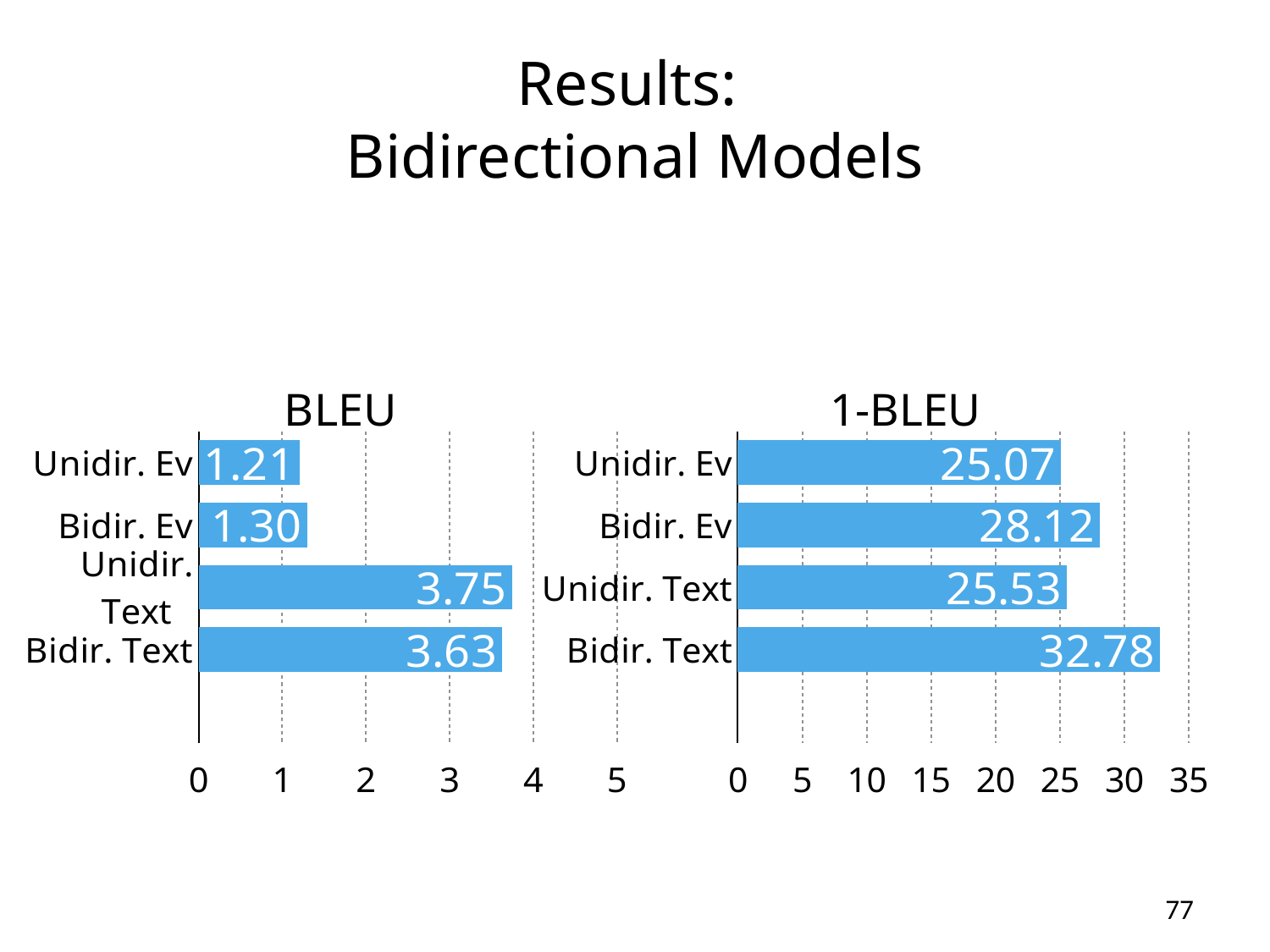
In the BLEU chart, what is the difference between Unidir. Text and Bidir. Text? 0.12 In the 1-BLEU chart, which category has the highest value? Bidir. Text In the BLEU chart, which is larger, Unidir. Ev or Bidir. Ev? Bidir. Ev In the 1-BLEU chart, what is the difference between Bidir. Text and Bidir. Ev? 4.66 In the 1-BLEU chart, what is the value for Unidir. Text? 25.53 What is the title of the chart on the left? BLEU In the 1-BLEU chart, is the value for Bidir. Text greater or less than 30? greater In the 1-BLEU chart, which category has the lowest value? Unidir. Ev What kind of chart is the 1-BLEU chart? bar chart In the BLEU chart, what is the value for Bidir. Ev? 1.30 How many categories does the BLEU chart show? 4 In the BLEU chart, which category has the highest value? Unidir. Text